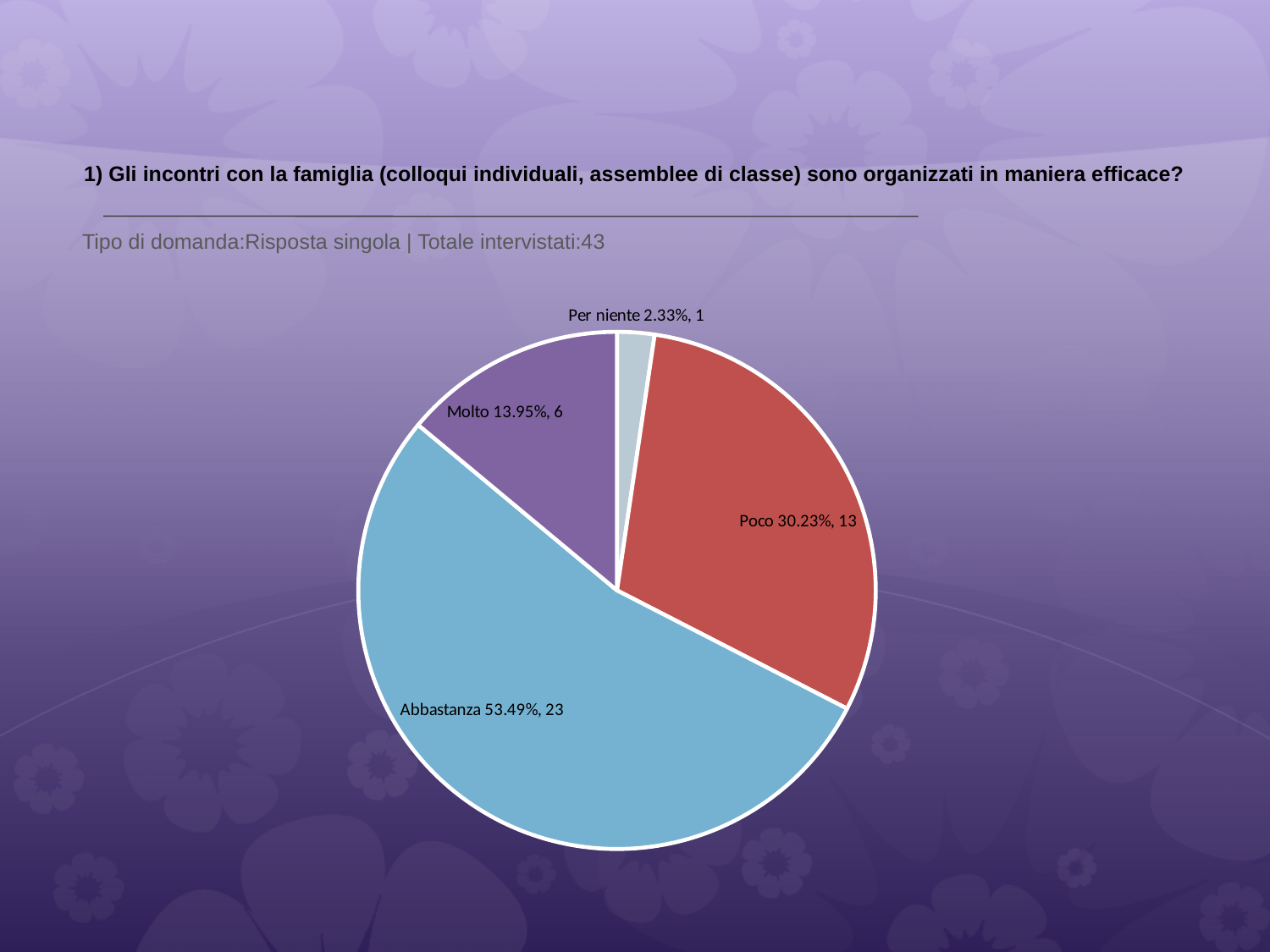
How many respondents answered 'Poco'? 13 Which response category has the smallest slice? Per niente What percentage share does the 'Abbastanza' slice have? 53.49% What is the difference in respondent count between 'Abbastanza' and 'Poco'? 10 What kind of chart is shown on the slide? pie chart Which has more respondents, 'Molto' or 'Poco'? Poco How many slices does the pie chart have? 4 What is the total number of respondents stated on the slide? 43 Which response category has the largest slice? Abbastanza What percentage share does the 'Molto' slice have? 13.95% How many respondents answered 'Per niente'? 1 What colour is the 'Abbastanza' slice? light blue